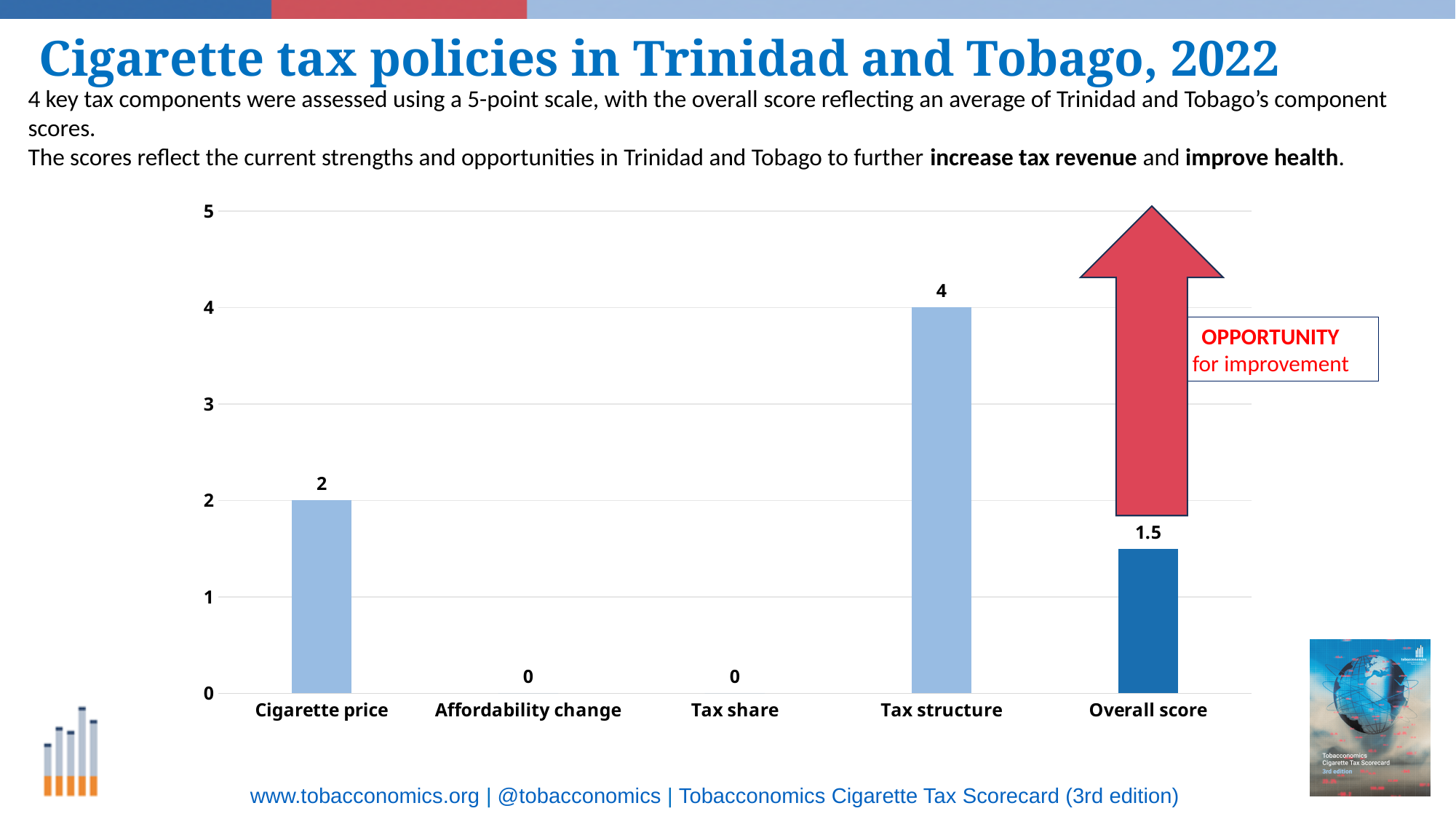
What is the score for Cigarette price? 2 What is the maximum value shown on the y axis? 5 What is the Overall score? 1.5 Is the value for Tax structure greater or less than 3? greater Which is larger, the score for Cigarette price or the Overall score? Cigarette price What is the difference between the Tax structure score and the Cigarette price score? 2 What is the score for Affordability change? 0 How many categories are shown on the x axis? 5 What kind of chart is shown on the slide? bar chart How many categories have a score of 0? 2 Which category has the highest score? Tax structure What is the score for Tax structure? 4